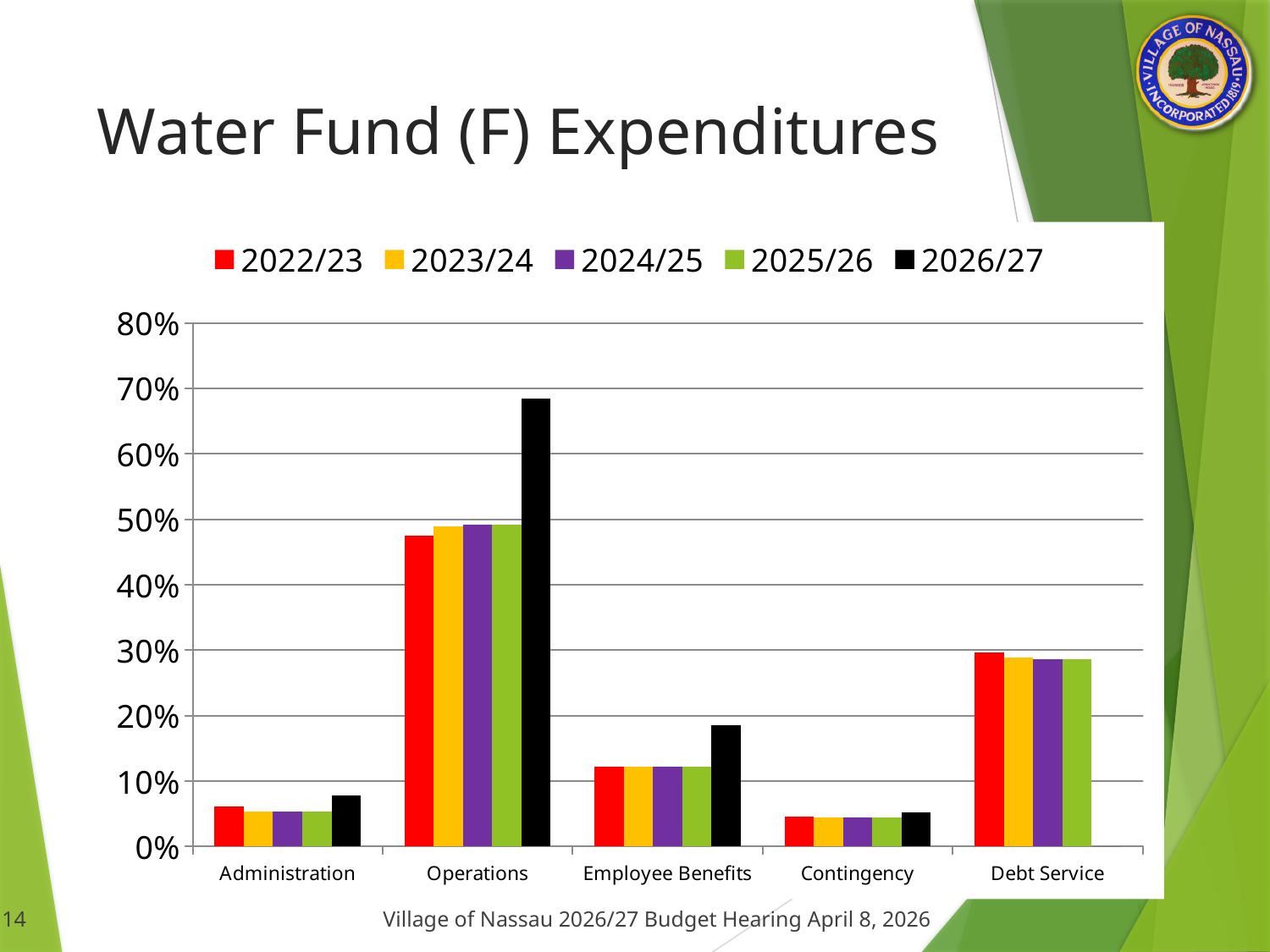
Is the 2026/27 value for Operations greater or less than 60%? greater Is the 2022/23 value for Debt Service greater or less than 20%? greater For Operations, which is larger: the 2022/23 value or the 2026/27 value? 2026/27 How many series does the legend list? 5 Is the 2022/23 value for Administration greater or less than 10%? less What colour represents the 2026/27 series in the legend? black Which category has the highest value for the 2026/27 series? Operations What kind of chart is shown on the slide? bar chart For the 2026/27 series, which is larger: Administration or Contingency? Administration Which category has the lowest value for the 2022/23 series? Contingency How many expenditure categories are shown on the x axis? 5